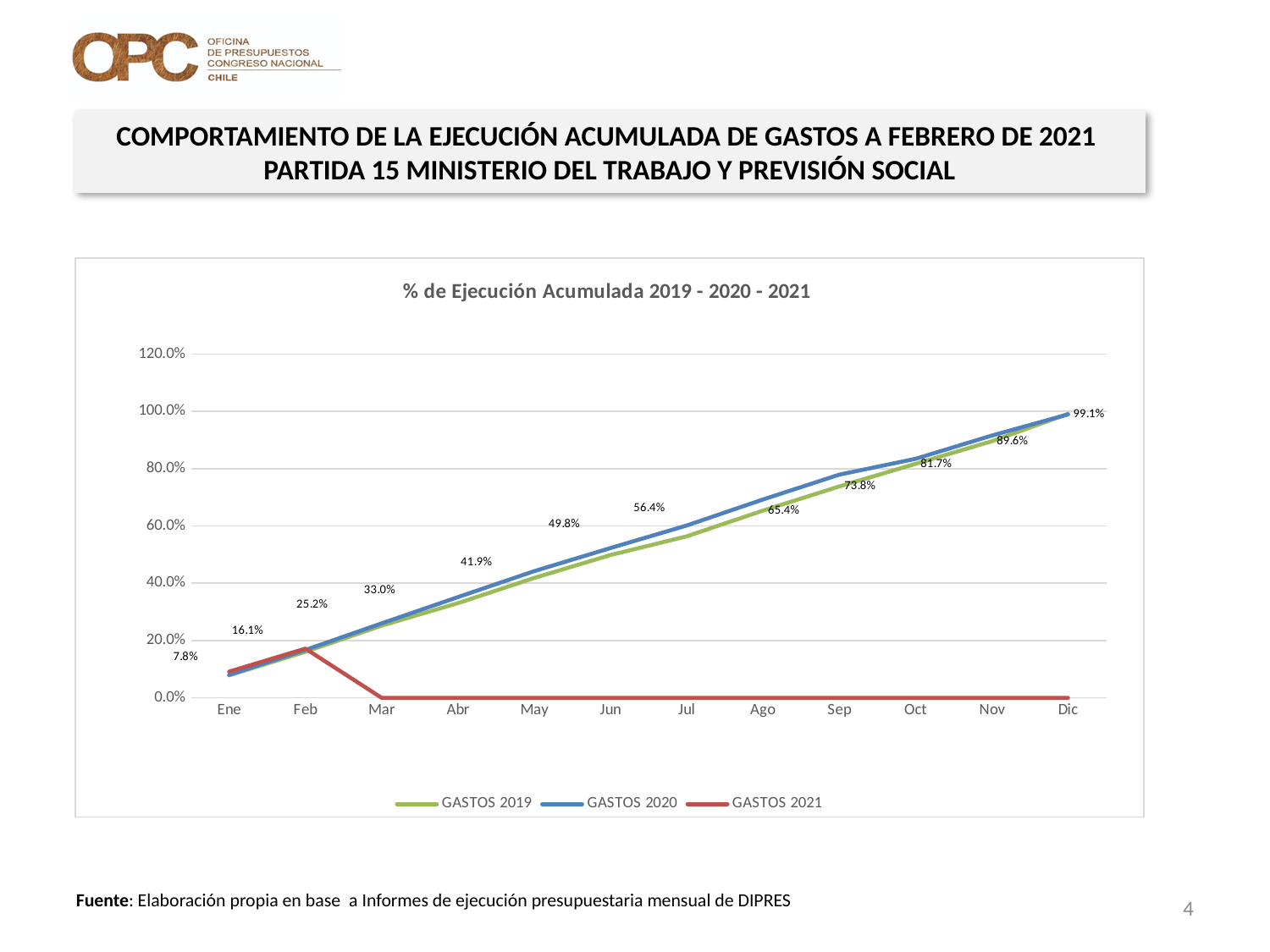
Is the value for GASTOS 2020 at Dic greater or less than 80.0%? greater Does the GASTOS 2020 line rise or fall from Ene to Dic? rises Is the value for GASTOS 2021 at Mar greater or less than 20.0%? less Which series has the lowest value at Dic? GASTOS 2021 How many series does the legend list? 3 How many months are shown along the x axis? 12 What kind of chart is shown on the slide? line chart What value is labelled at Dic? 99.1% Is the value for GASTOS 2019 at Jun greater or less than 60.0%? less Which colour is used for the GASTOS 2021 line? red What is the title of the chart? % de Ejecución Acumulada 2019 - 2020 - 2021 At Mar, which is larger: GASTOS 2020 or GASTOS 2021? GASTOS 2020